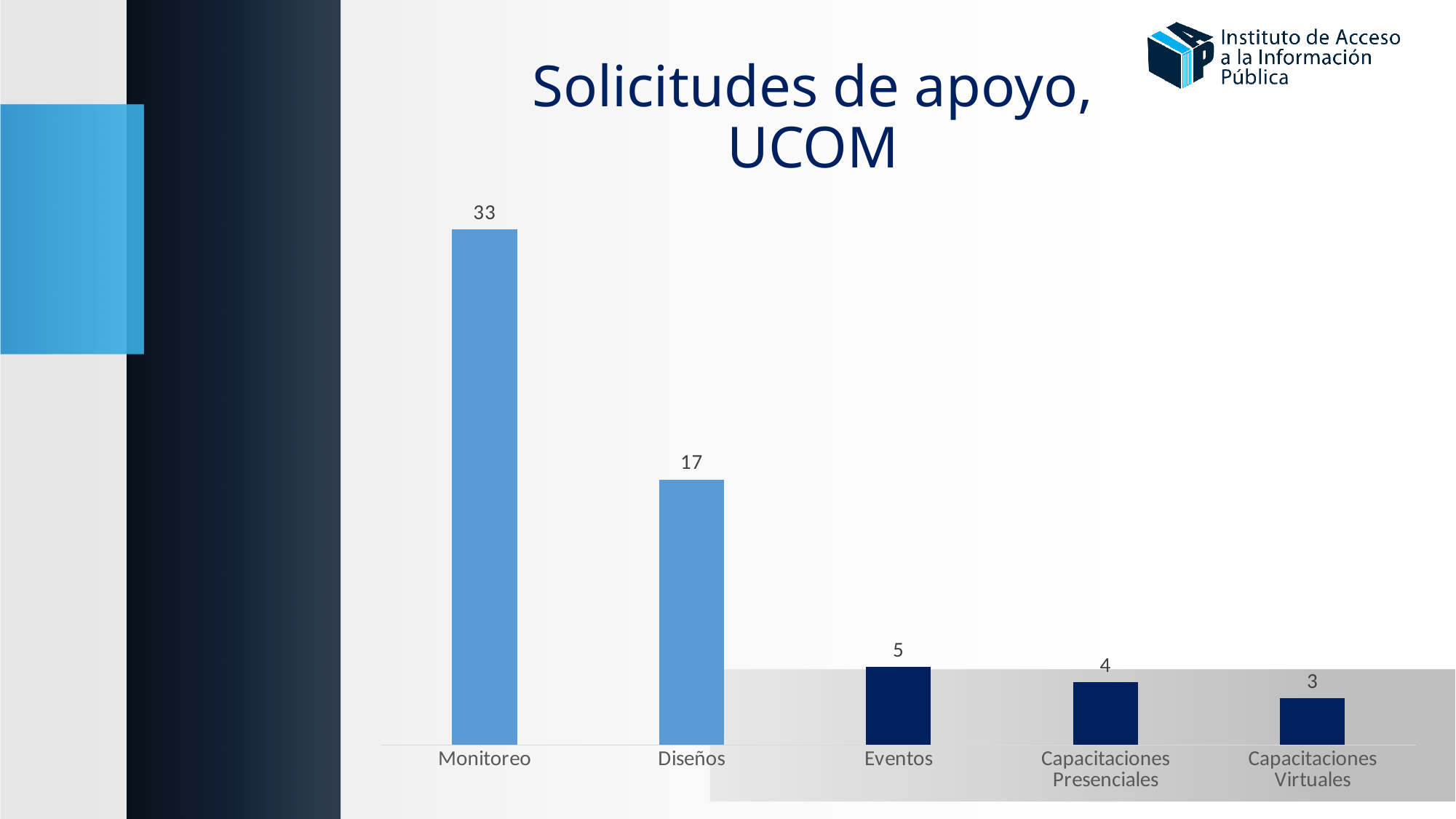
Which category has the highest value? Monitoreo What is the difference between the values for Monitoreo and Diseños? 16 What kind of chart is shown on the slide? Bar chart What is the value for Capacitaciones Virtuales? 3 Which is larger, the value for Eventos or the value for Capacitaciones Presenciales? Eventos What is the title of the slide? Solicitudes de apoyo, UCOM What is the value for Eventos? 5 What is the value for Monitoreo? 33 How many categories are shown in the chart? 5 What is the value for Capacitaciones Presenciales? 4 What is the value for Diseños? 17 Which category has the lowest value? Capacitaciones Virtuales